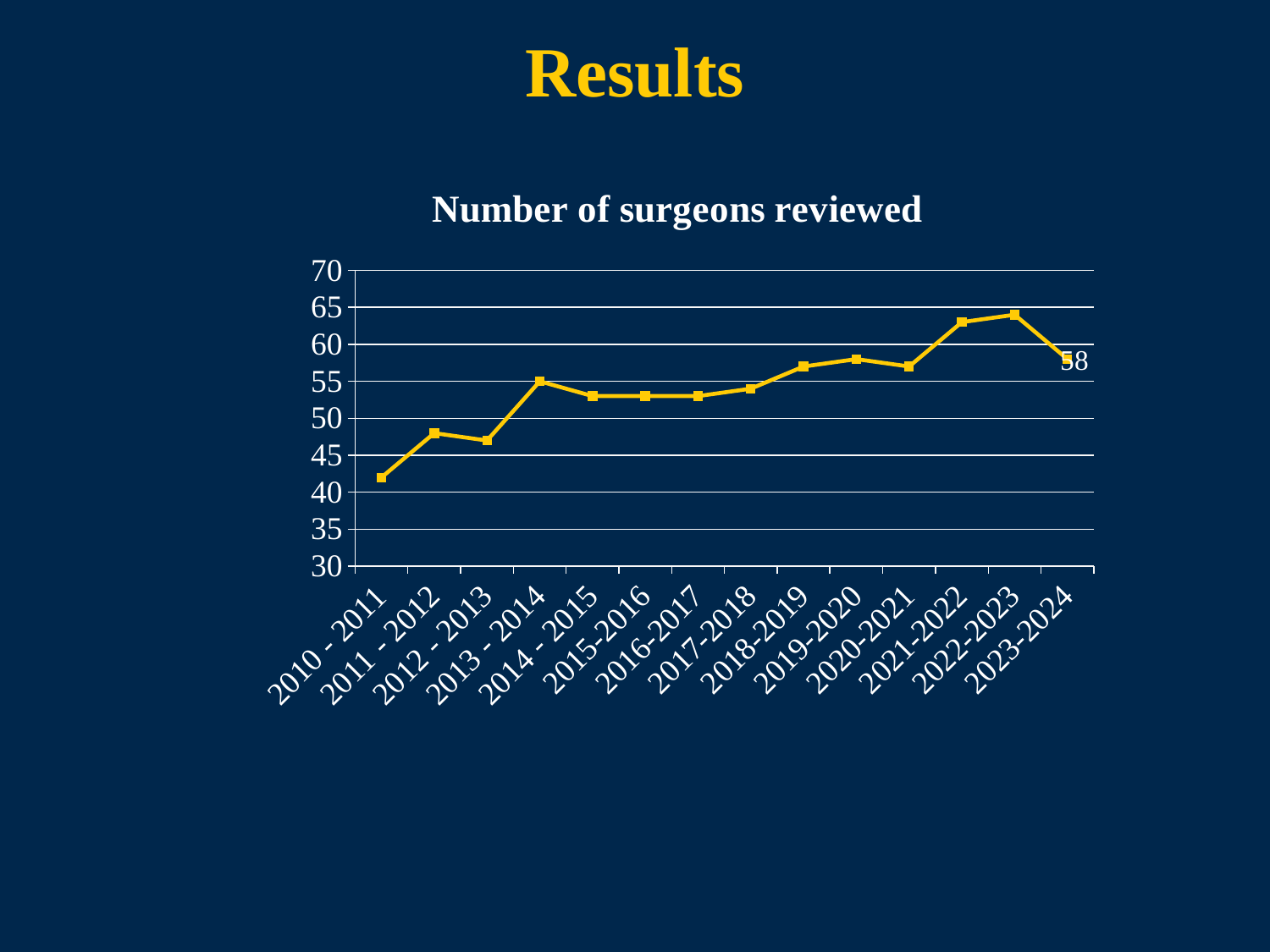
Is the value for 2021-2022 greater or less than 60? greater Is the value for 2018-2019 greater or less than 55? greater What is the title of the chart? Number of surgeons reviewed Does the number of surgeons reviewed rise or fall from 2010 - 2011 to 2013 - 2014? rise What kind of chart is shown on the slide? line chart Which period has the lowest number of surgeons reviewed? 2010 - 2011 How many time periods are plotted along the x axis? 14 What colour is the plotted line? yellow Which is larger, the value for 2022-2023 or the value for 2023-2024? 2022-2023 What is the number of surgeons reviewed for 2023-2024? 58 Is the value for 2010 - 2011 greater or less than 45? less